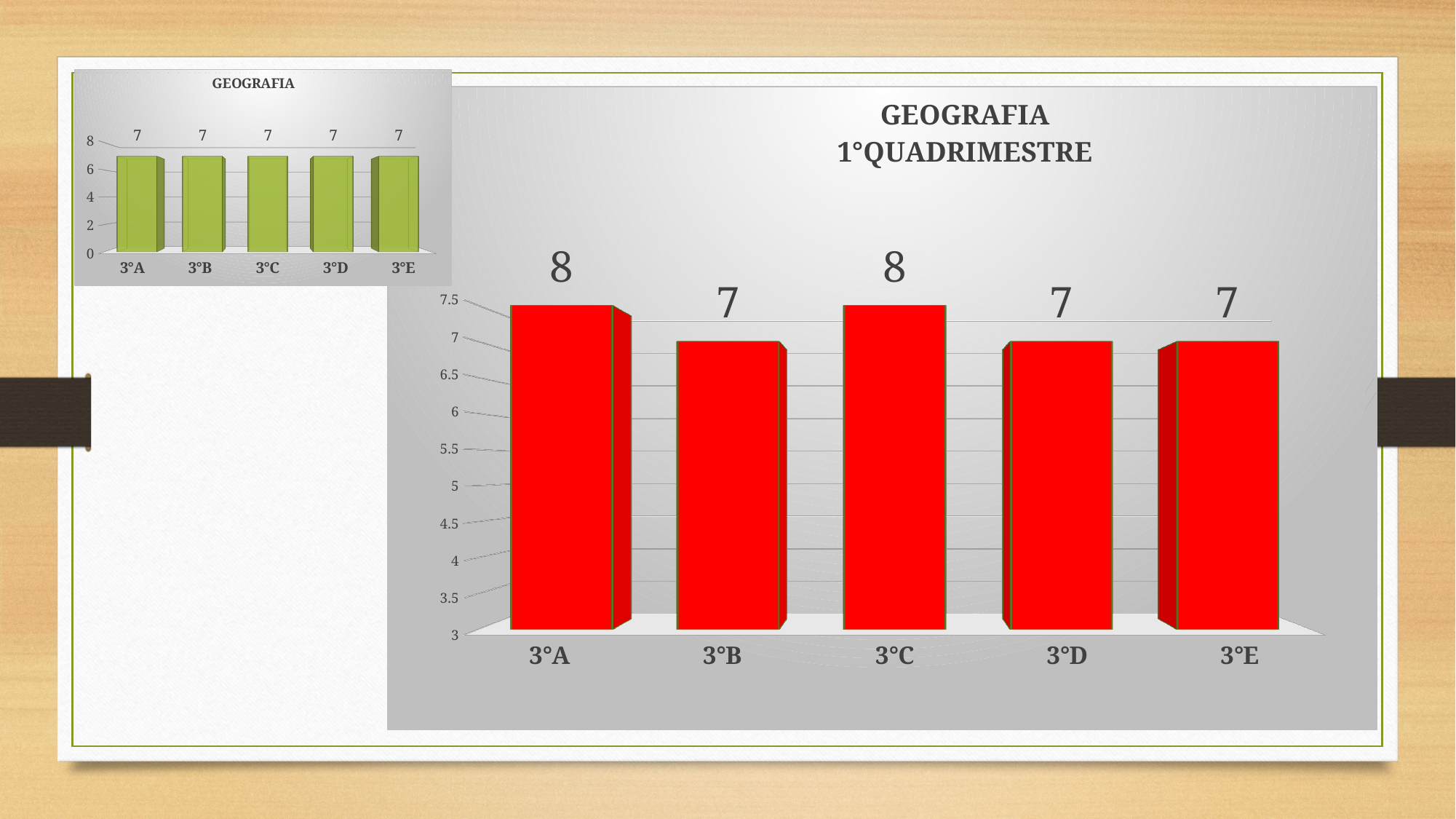
In the GEOGRAFIA 1°QUADRIMESTRE chart, what is the value for 3°D? 7 In the GEOGRAFIA 1°QUADRIMESTRE chart, which is larger, the value for 3°C or the value for 3°E? 3°C In the GEOGRAFIA 1°QUADRIMESTRE chart, what is the value for 3°A? 8 What colour are the bars in the GEOGRAFIA 1°QUADRIMESTRE chart? Red What is the title of the large chart on the right side of the slide? GEOGRAFIA 1°QUADRIMESTRE In the small GEOGRAFIA chart at the top left, what is the value for 3°B? 7 How many categories are shown in the small GEOGRAFIA chart at the top left? 5 How many categories are shown in the GEOGRAFIA 1°QUADRIMESTRE chart? 5 In the GEOGRAFIA 1°QUADRIMESTRE chart, what is the value for 3°C? 8 In the small GEOGRAFIA chart at the top left, is the value for 3°D greater or less than 4? greater What kind of chart is the GEOGRAFIA 1°QUADRIMESTRE chart? Bar chart In the GEOGRAFIA 1°QUADRIMESTRE chart, what is the difference between the values for 3°A and 3°B? 1